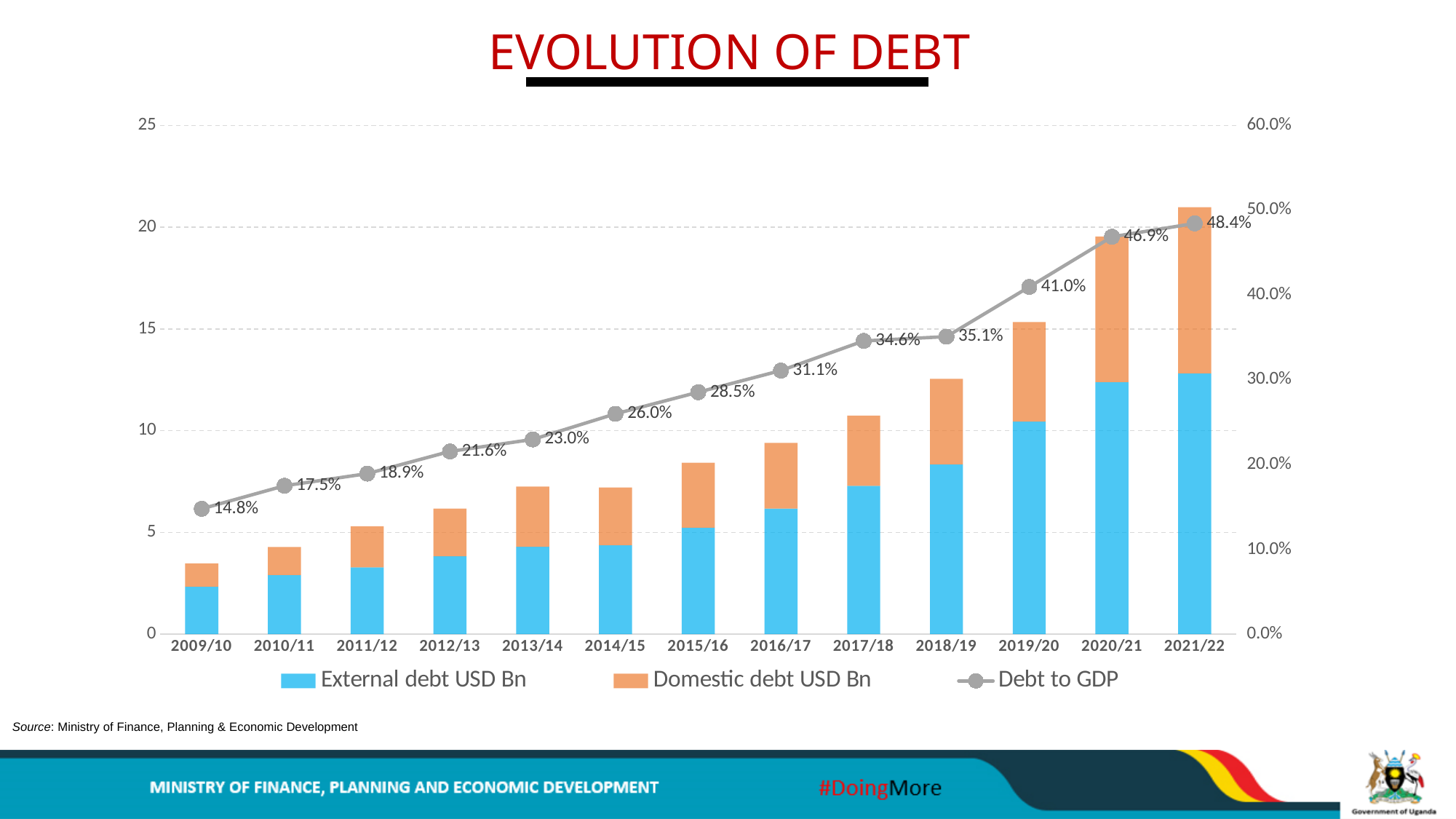
How many fiscal years are shown on the x axis? 13 Is the External debt USD Bn value for 2021/22 greater or less than 10? greater What is the Debt to GDP value for 2016/17? 31.1% Is the total debt (External plus Domestic) for 2009/10 greater or less than 5? less Which year has a higher Debt to GDP ratio, 2013/14 or 2017/18? 2017/18 What is the difference in Debt to GDP between 2020/21 and 2019/20? 5.9% What is the Debt to GDP value for 2021/22? 48.4% What is the Debt to GDP value for 2009/10? 14.8% How many series does the legend list? 3 In which year is the Debt to GDP ratio lowest? 2009/10 In which year is the Debt to GDP ratio highest? 2021/22 Does the Debt to GDP ratio rise or fall from 2009/10 to 2021/22? rise